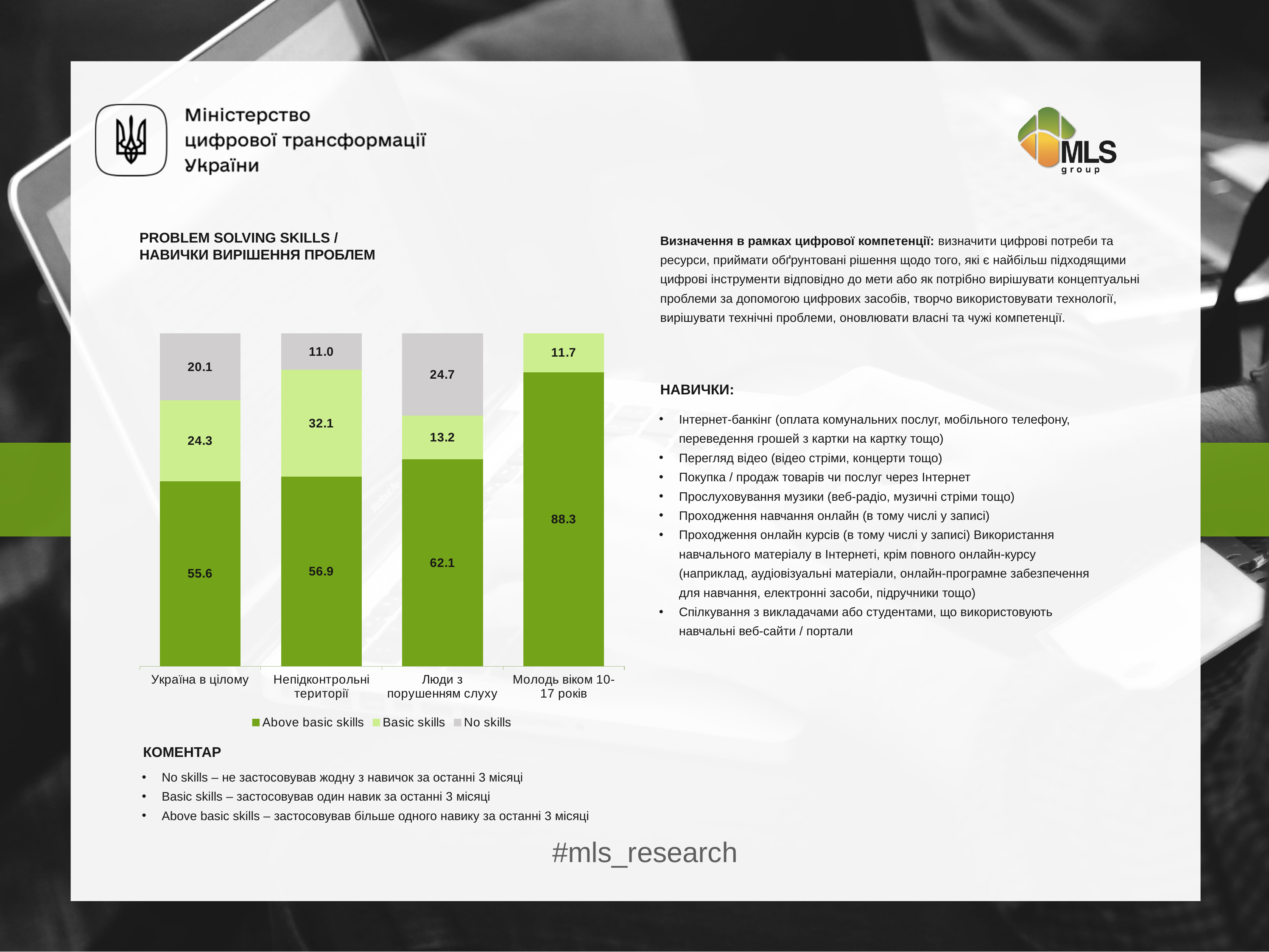
Which is larger: the No skills value for Україна в цілому or for Непідконтрольні території? Україна в цілому How many series does the chart legend list? 3 What is the value of Basic skills for Непідконтрольні території? 32.1 Which category has the highest value for Above basic skills? Молодь віком 10-17 років What is the difference between the Above basic skills values for Люди з порушенням слуху and Україна в цілому? 6.5 What is the value of Above basic skills for Україна в цілому? 55.6 What is the value of Above basic skills for Молодь віком 10-17 років? 88.3 How many categories are shown on the x axis of the chart? 4 What is the total of the stacked bar for Україна в цілому? 100.0 Which category has the lowest value for Basic skills? Молодь віком 10-17 років What is the value of No skills for Люди з порушенням слуху? 24.7 What type of chart is shown on the slide? Stacked bar chart